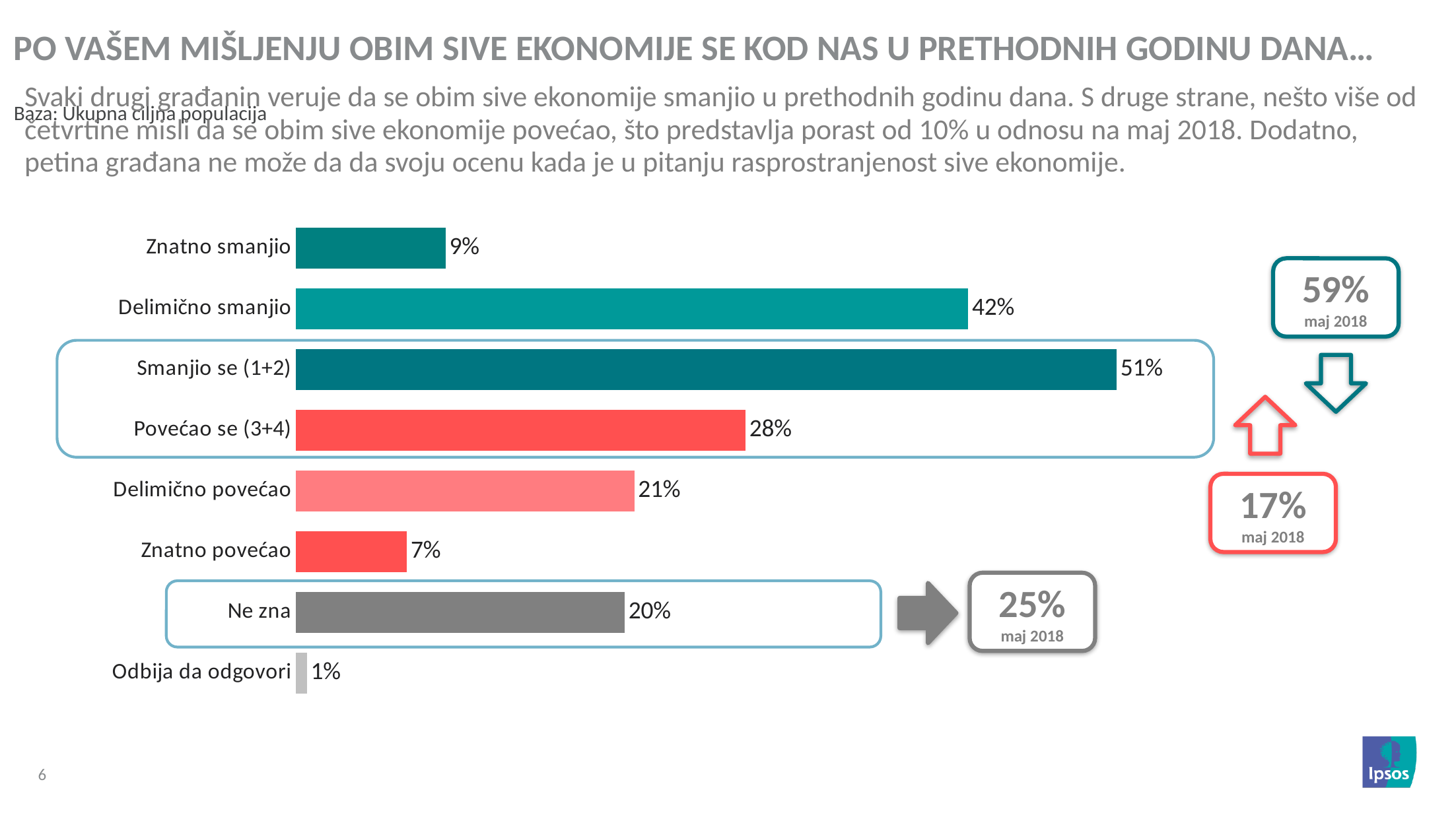
What was the value for "Ne zna" in maj 2018, as shown in the callout box? 25% How many categories are shown in the chart? 8 Which category has the highest value? Smanjio se (1+2) What is the difference between "Smanjio se (1+2)" and "Povećao se (3+4)"? 23% What is the value for "Povećao se (3+4)"? 28% What is the value for "Znatno povećao"? 7% Which is larger, "Delimično povećao" or "Ne zna"? Delimično povećao Which category has the lowest value? Odbija da odgovori What kind of chart is shown on the slide? Bar chart What is the value for "Delimično smanjio"? 42% What is the value for "Ne zna"? 20% What colour is the bar for "Povećao se (3+4)"? Red